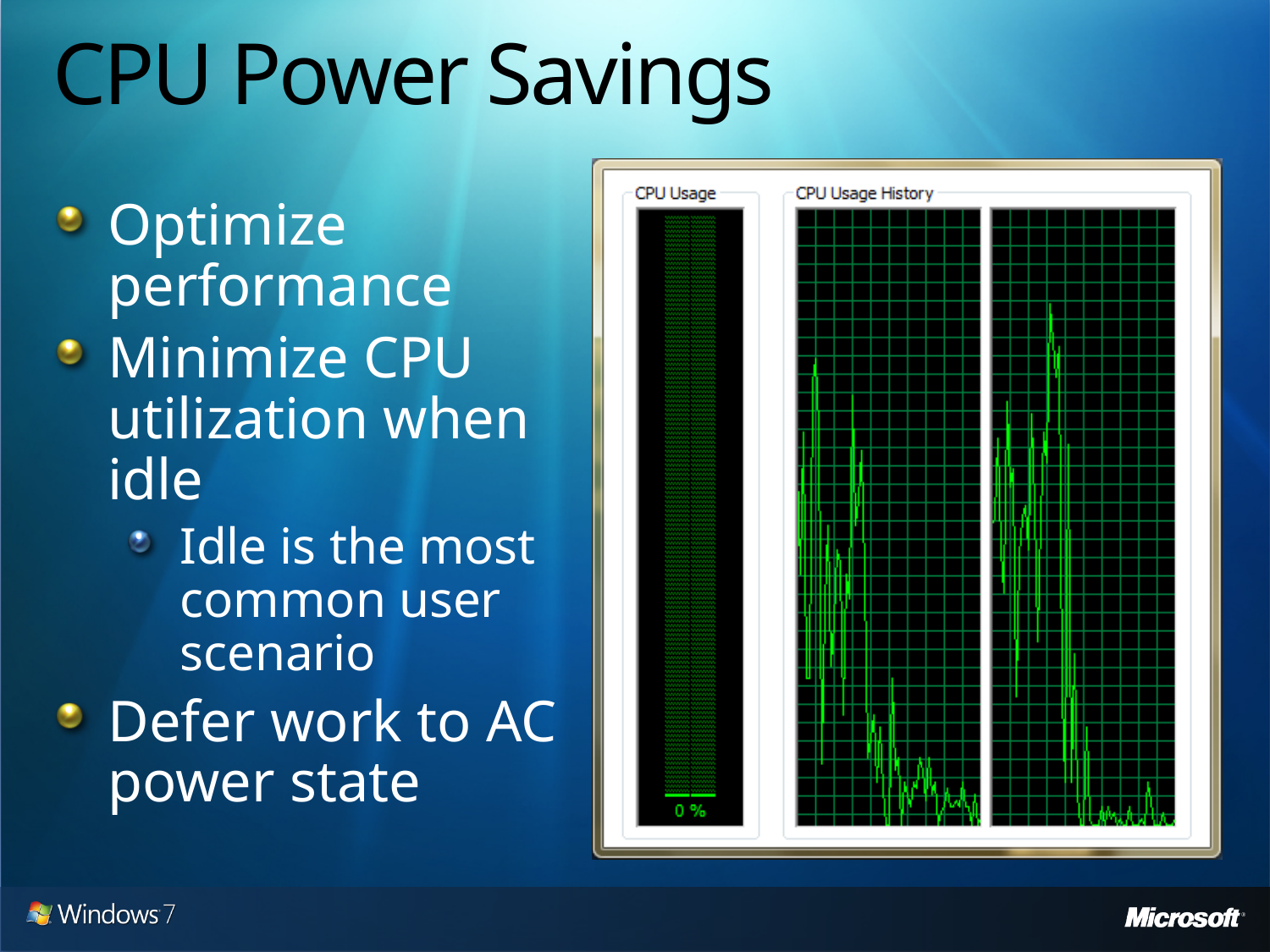
In the right CPU Usage History graph, does CPU usage generally rise or fall from left to right? fall What is the title of the narrow panel on the left side of the screenshot? CPU Usage In the CPU Usage History panel, what kind of chart is used to show usage over time? line chart What colour are the usage lines in the CPU Usage History graphs? green What value is printed at the bottom of the CPU Usage gauge? 0 % In the left CPU Usage History graph, does CPU usage generally rise or fall from left to right? fall What is the title of the panel on the right side of the screenshot? CPU Usage History How many separate history graphs are shown in the CPU Usage History panel? 2